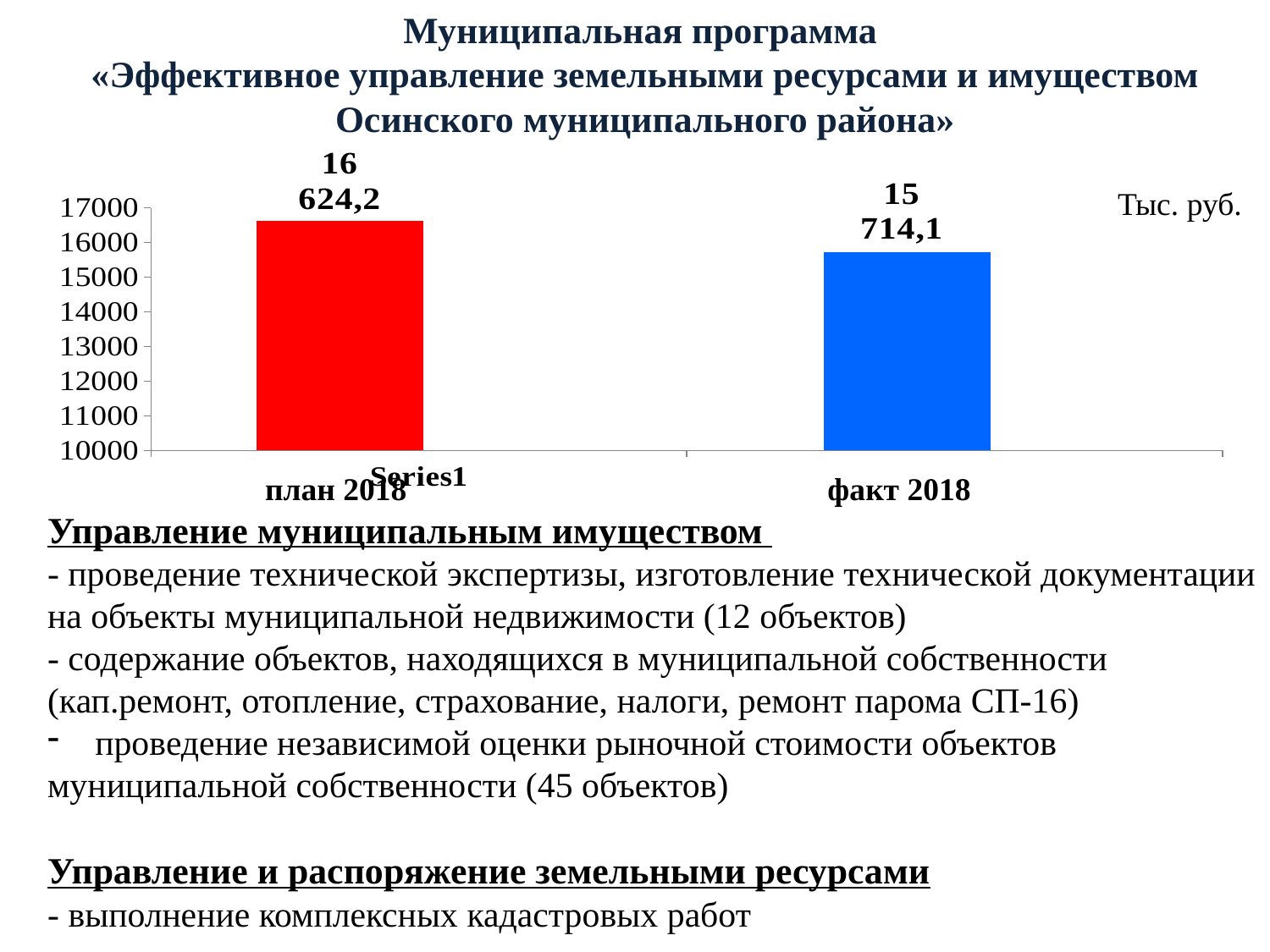
How many bars are shown in the chart? 2 Is the value for факт 2018 greater or less than 16000? less What is the value for план 2018? 16 624,2 Which category has the lowest value? факт 2018 What kind of chart is shown on the slide? bar chart Is the value for план 2018 greater or less than 16000? greater What colour is the bar for факт 2018? blue What is the difference between the план 2018 and факт 2018 values? 910,1 What is the value for факт 2018? 15 714,1 Which category has the highest value? план 2018 Which category has the higher value, план 2018 or факт 2018? план 2018 What unit is indicated for the chart values? Тыс. руб.